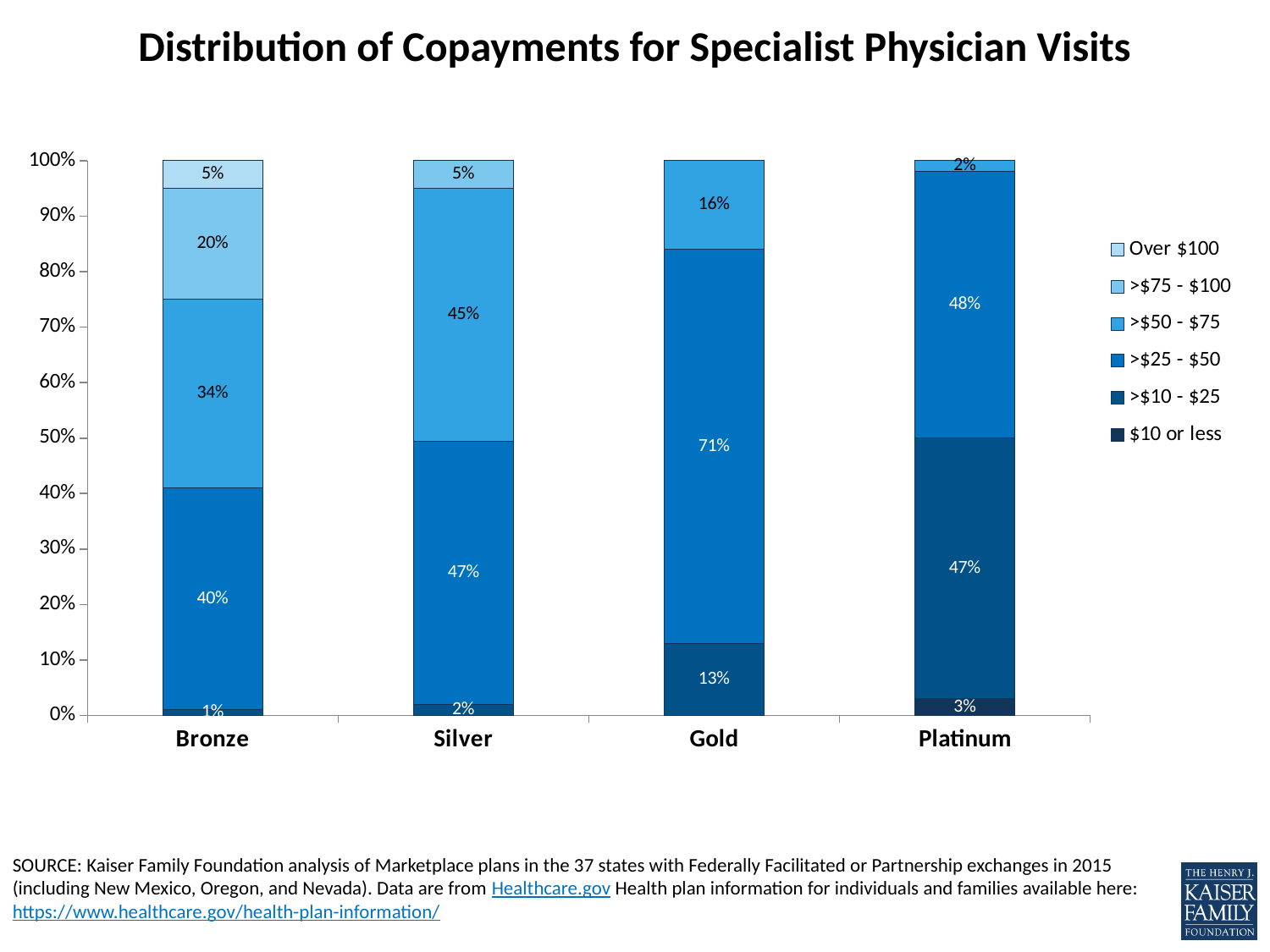
Which plan type has the largest share of plans in the >$25 - $50 copayment range? Gold How many plan categories are shown on the x axis? 4 What share of Platinum plans have a specialist copayment of $10 or less? 3% What is the largest single segment value in the Platinum bar? 48% What is the difference in percentage points between the >$10 - $25 share for Platinum and for Gold? 34 percentage points What share of Bronze plans have a specialist copayment of Over $100? 5% What kind of chart is shown on the slide? Stacked bar chart What share of Gold plans have a specialist copayment of >$10 - $25? 13% How many series does the legend list? 6 What share of Gold plans have a specialist copayment of >$25 - $50? 71% What is the title of the chart? Distribution of Copayments for Specialist Physician Visits